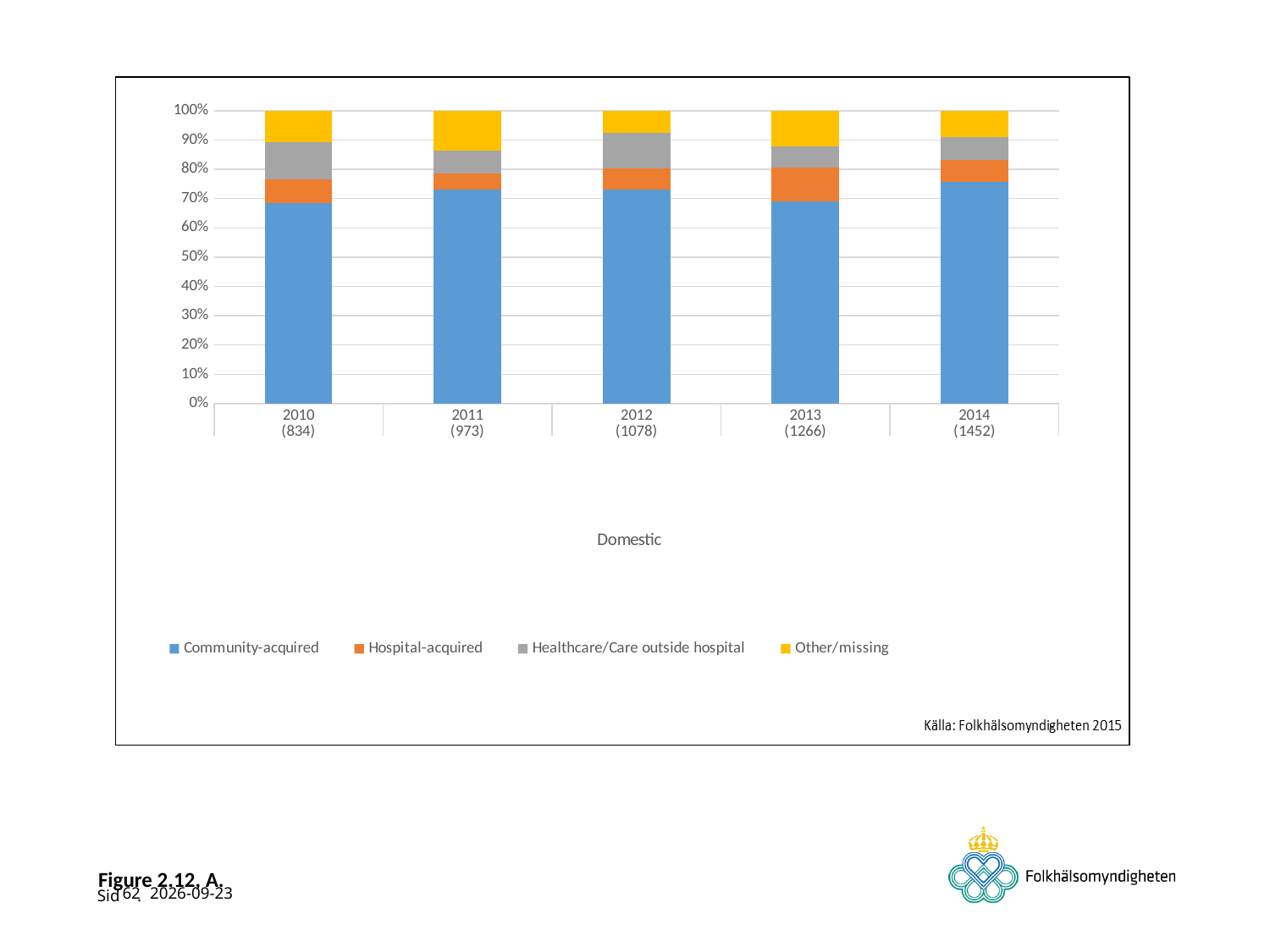
Is the Community-acquired share for 2010 greater or less than 60%? greater Is the Community-acquired share for 2014 greater or less than 70%? greater What source is cited at the bottom right of the chart? Källa: Folkhälsomyndigheten 2015 How many series does the legend list? 4 Is the Community-acquired share for 2013 greater or less than 80%? less Which is larger, the Other/missing share in 2011 or in 2012? 2011 What number is shown in parentheses under the 2014 category label? 1452 What kind of chart is shown on the slide? stacked bar chart How many years (categories) are shown on the x axis? 5 Which is larger, the Community-acquired share in 2014 or in 2010? 2014 What label appears below the x axis categories? Domestic What is the total of the stacked bar for 2012? 100%